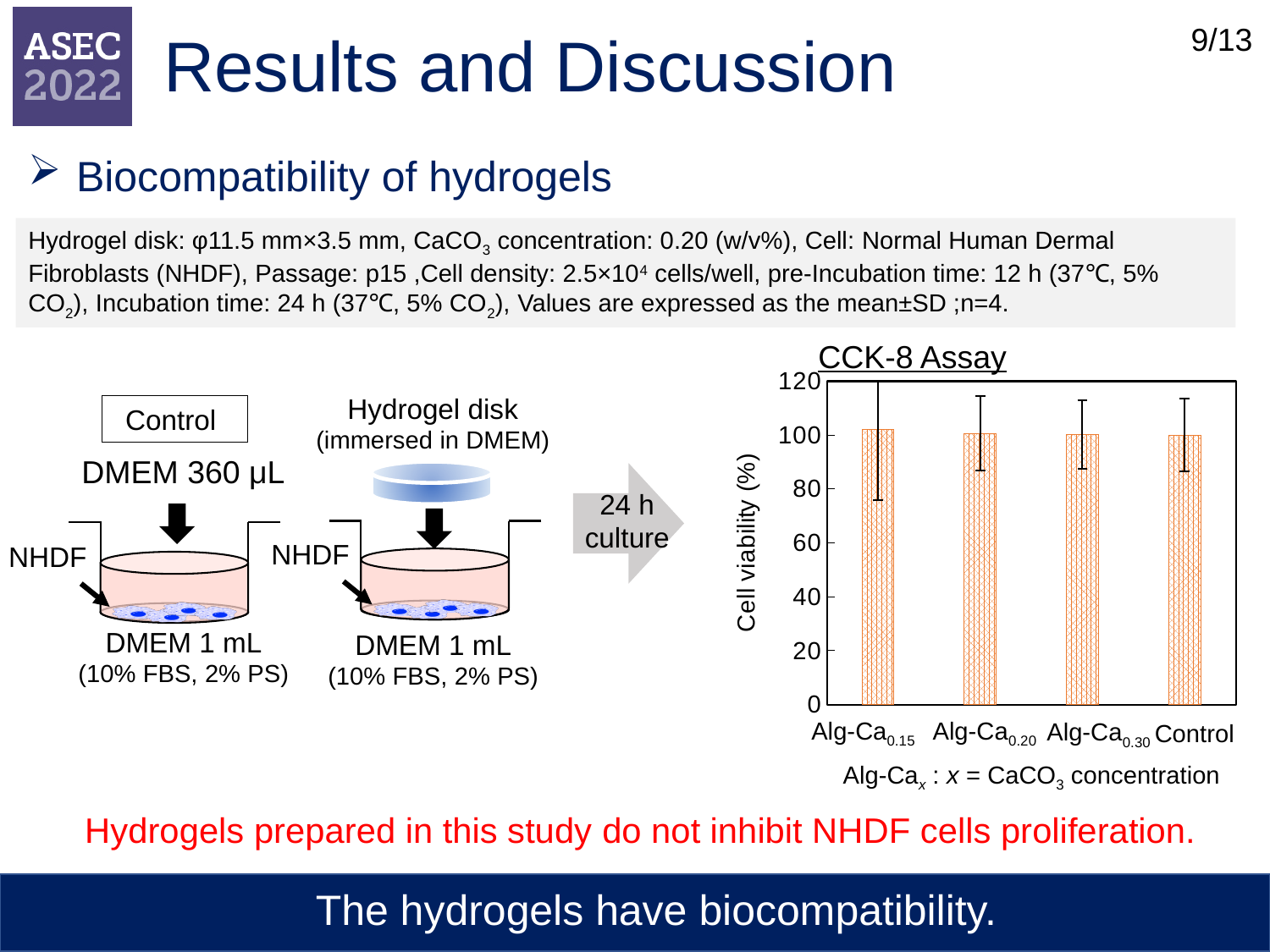
How many categories are shown on the x axis of the CCK-8 Assay chart? 4 In the CCK-8 Assay chart, is the value for Control greater or less than 80? greater In the CCK-8 Assay chart, is the value for Alg-Ca0.15 greater or less than 80? greater In the CCK-8 Assay chart, is the value for Alg-Ca0.20 greater or less than 60? greater What is the y-axis label of the CCK-8 Assay chart? Cell viability (%) What is the maximum value shown on the y axis of the CCK-8 Assay chart? 120 What is the title of the chart on the slide? CCK-8 Assay What kind of chart is the CCK-8 Assay chart? bar chart